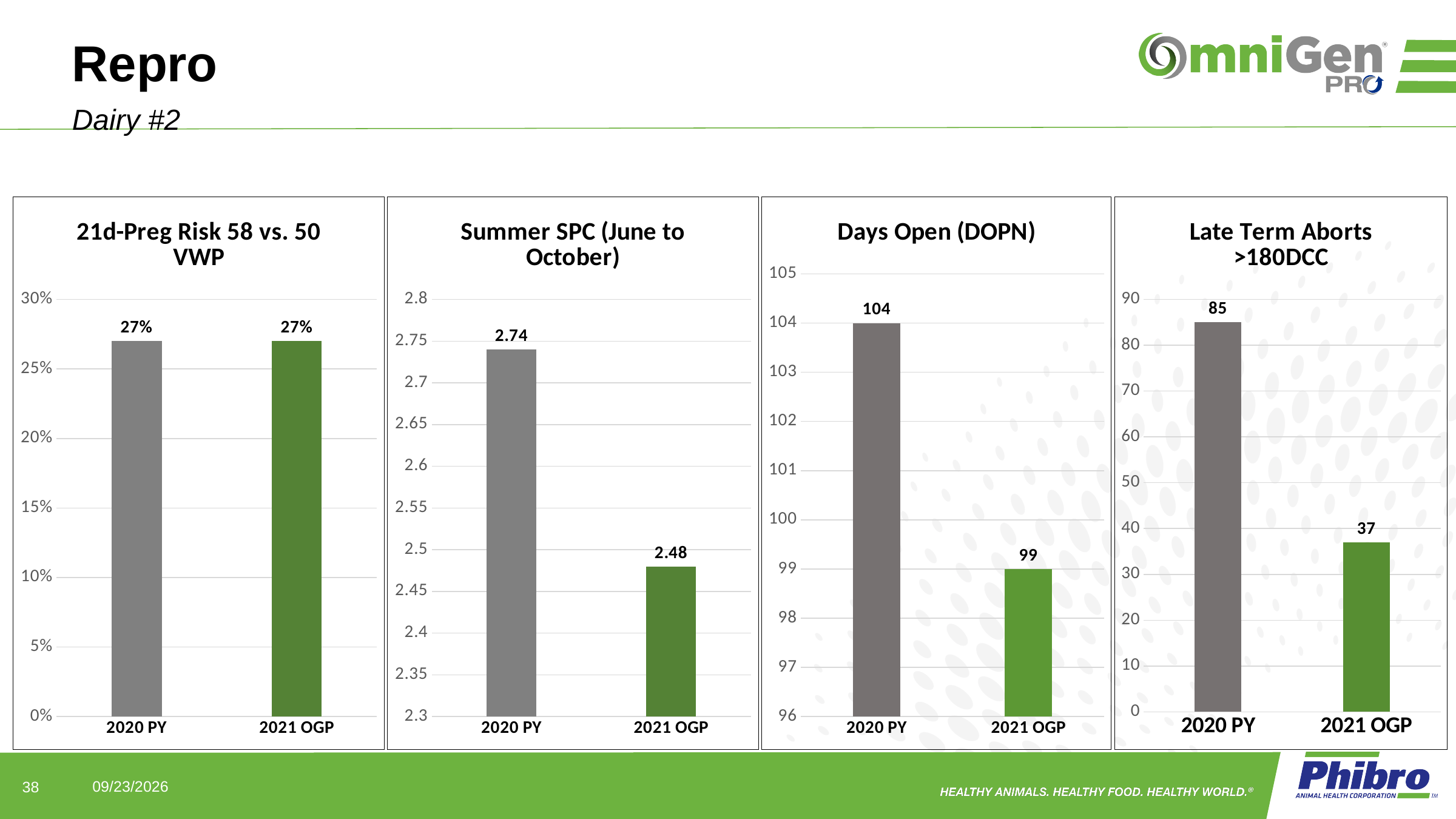
In the 'Summer SPC (June to October)' chart, what is the value for 2020 PY? 2.74 In the 'Days Open (DOPN)' chart, which category has the lowest value? 2021 OGP In the 'Days Open (DOPN)' chart, what is the value for 2020 PY? 104 How many charts are shown on the slide? 4 In the 'Summer SPC (June to October)' chart, what is the value for 2021 OGP? 2.48 In the 'Days Open (DOPN)' chart, what is the difference between 2020 PY and 2021 OGP? 5 In the '21d-Preg Risk 58 vs. 50 VWP' chart, what is the value for 2021 OGP? 27% In the '21d-Preg Risk 58 vs. 50 VWP' chart, what is the value for 2020 PY? 27% In the 'Late Term Aborts >180DCC' chart, what is the value for 2021 OGP? 37 In the 'Late Term Aborts >180DCC' chart, what is the difference between 2020 PY and 2021 OGP? 48 In the 'Summer SPC (June to October)' chart, what is the difference between the 2020 PY and 2021 OGP values? 0.26 In the 'Late Term Aborts >180DCC' chart, which category has the highest value? 2020 PY